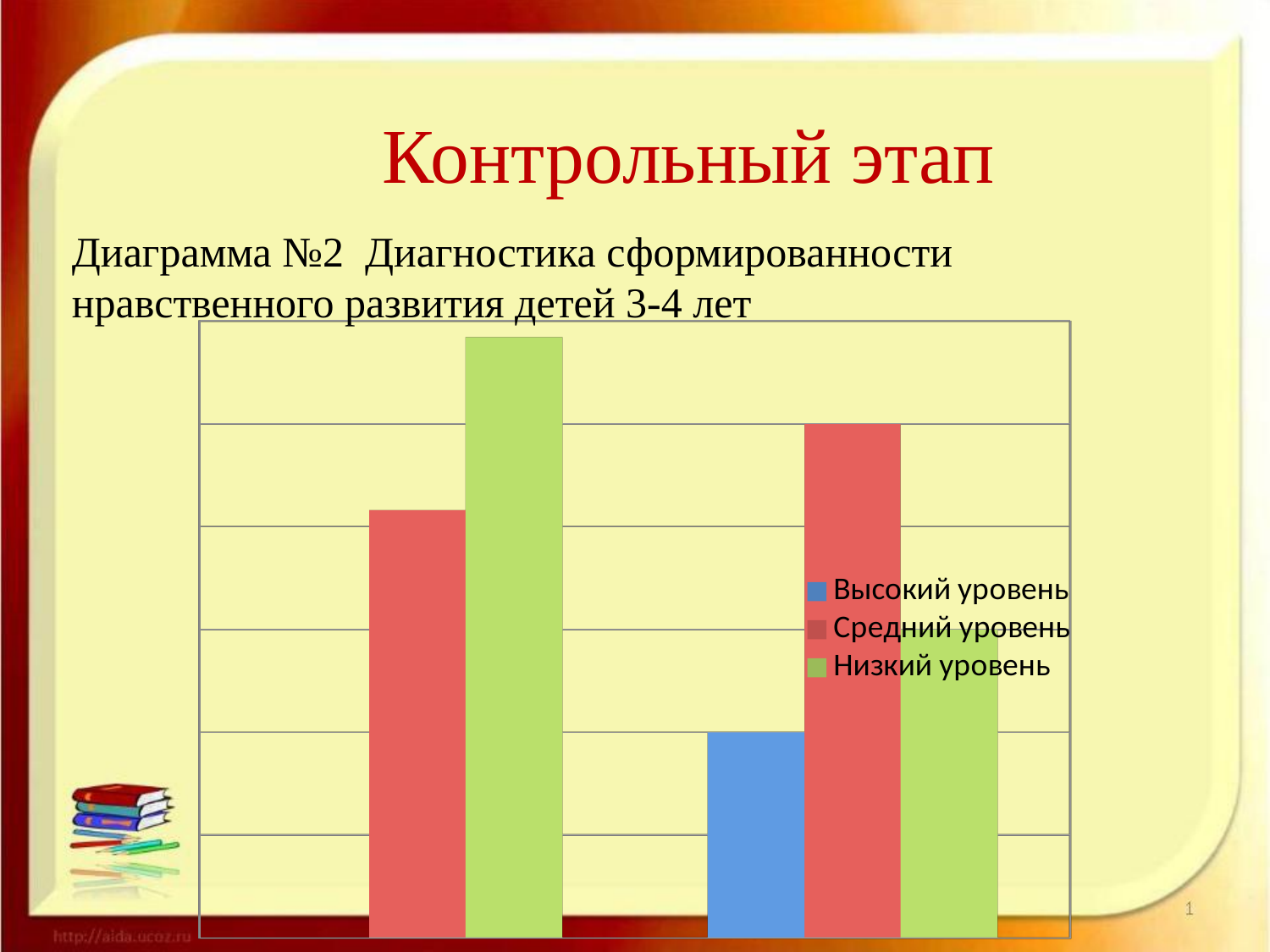
In the left group of bars, is the bar for Средний уровень taller or shorter than the bar for Низкий уровень? shorter How many bars are visible in the left group? 2 Is the Низкий уровень bar taller in the left group or in the right group? left group Is the Средний уровень bar taller in the left group or in the right group? right group In the right group of bars, which series has the tallest bar? Средний уровень Which colour represents Низкий уровень in the chart? green What are the three series named in the legend? Высокий уровень, Средний уровень, Низкий уровень In the right group of bars, which series has the shortest bar? Высокий уровень How many groups of bars are plotted in the chart? 2 In the left group of bars, which series has the tallest bar? Низкий уровень What kind of chart is shown on the slide? bar chart How many series does the legend list? 3